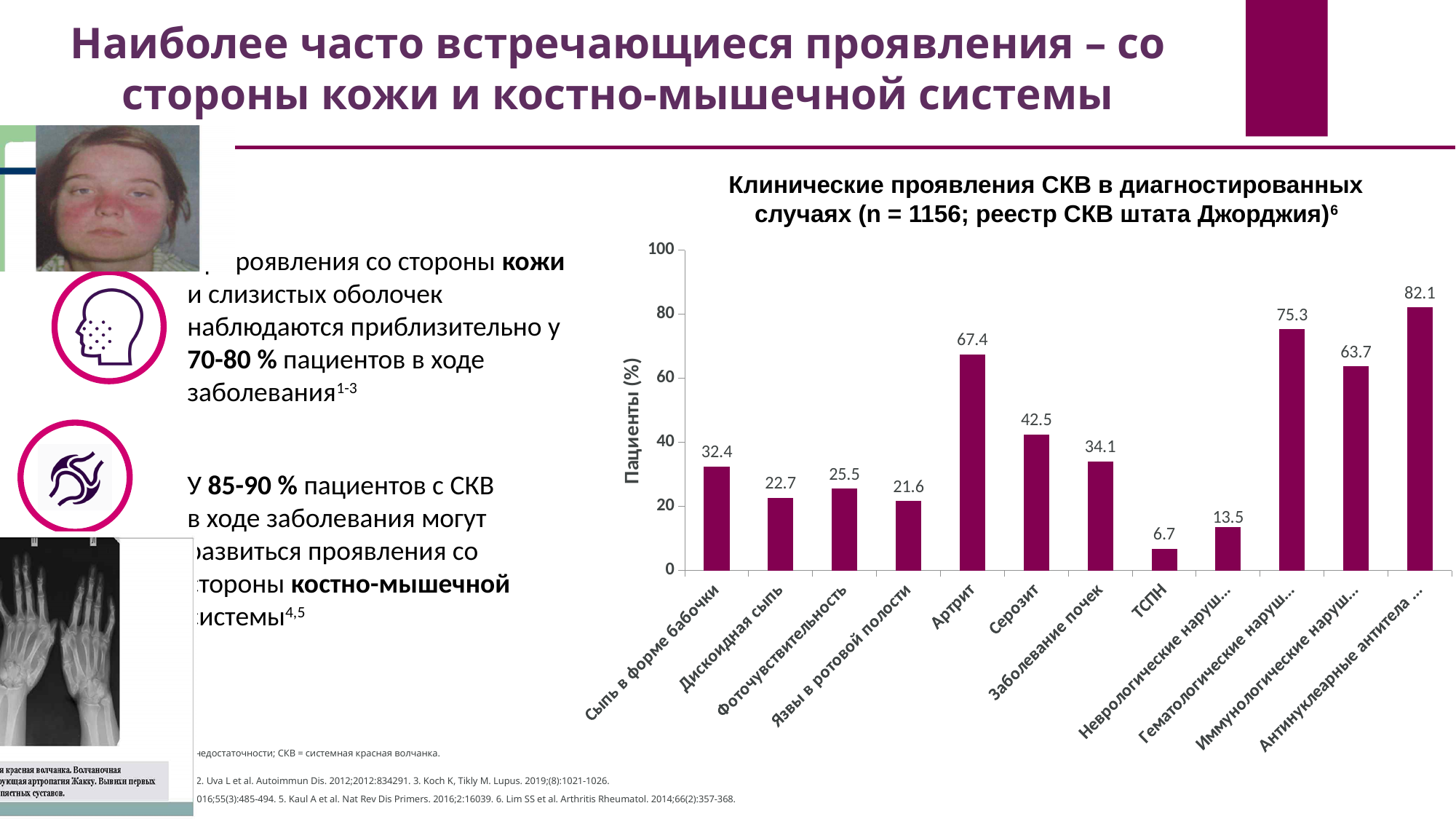
What is the value for Артрит in the chart? 67.4 How many categories are shown in the chart? 12 What is the value for Сыпь в форме бабочки? 32.4 Which category has the lowest value in the chart? ТСПН Which is larger, the value for Дискоидная сыпь or the value for Фоточувствительность? Фоточувствительность What is the difference between the values for Артрит and Серозит? 24.9 What is the highest value shown in the chart? 82.1 Is the value for Заболевание почек greater or less than 40? less What type of chart is shown on the slide? bar chart What is the label of the y axis of the chart? Пациенты (%) What is the value for ТСПН? 6.7 What is the value for Серозит in the chart? 42.5